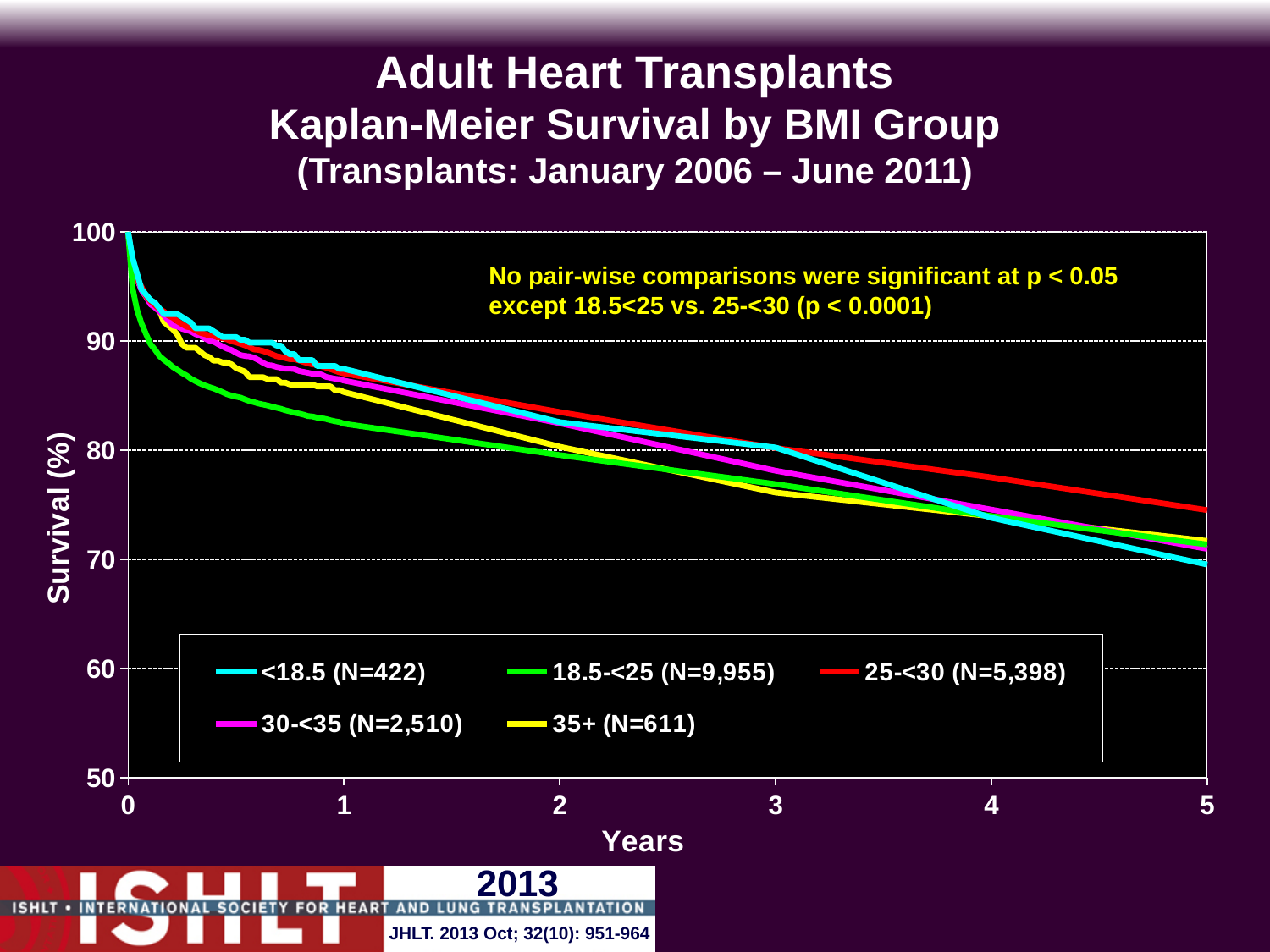
What is the N for the 25-<30 BMI group shown in the legend? 5,398 What is the N for the 35+ BMI group shown in the legend? 611 What is the label of the y axis? Survival (%) At 5 years, which group has higher survival: 25-<30 or <18.5? 25-<30 Do the survival curves rise or fall as years since transplant increase? Fall Is the survival for the 25-<30 group at 5 years greater or less than 70? greater Which BMI group has the highest survival at 5 years? 25-<30 (N=5,398) What kind of chart is shown on the slide? Line chart Which BMI group has the lowest survival at 1 year? 18.5-<25 (N=9,955) How many BMI groups (series) does the legend list? 5 What is the N for the 18.5-<25 BMI group shown in the legend? 9,955